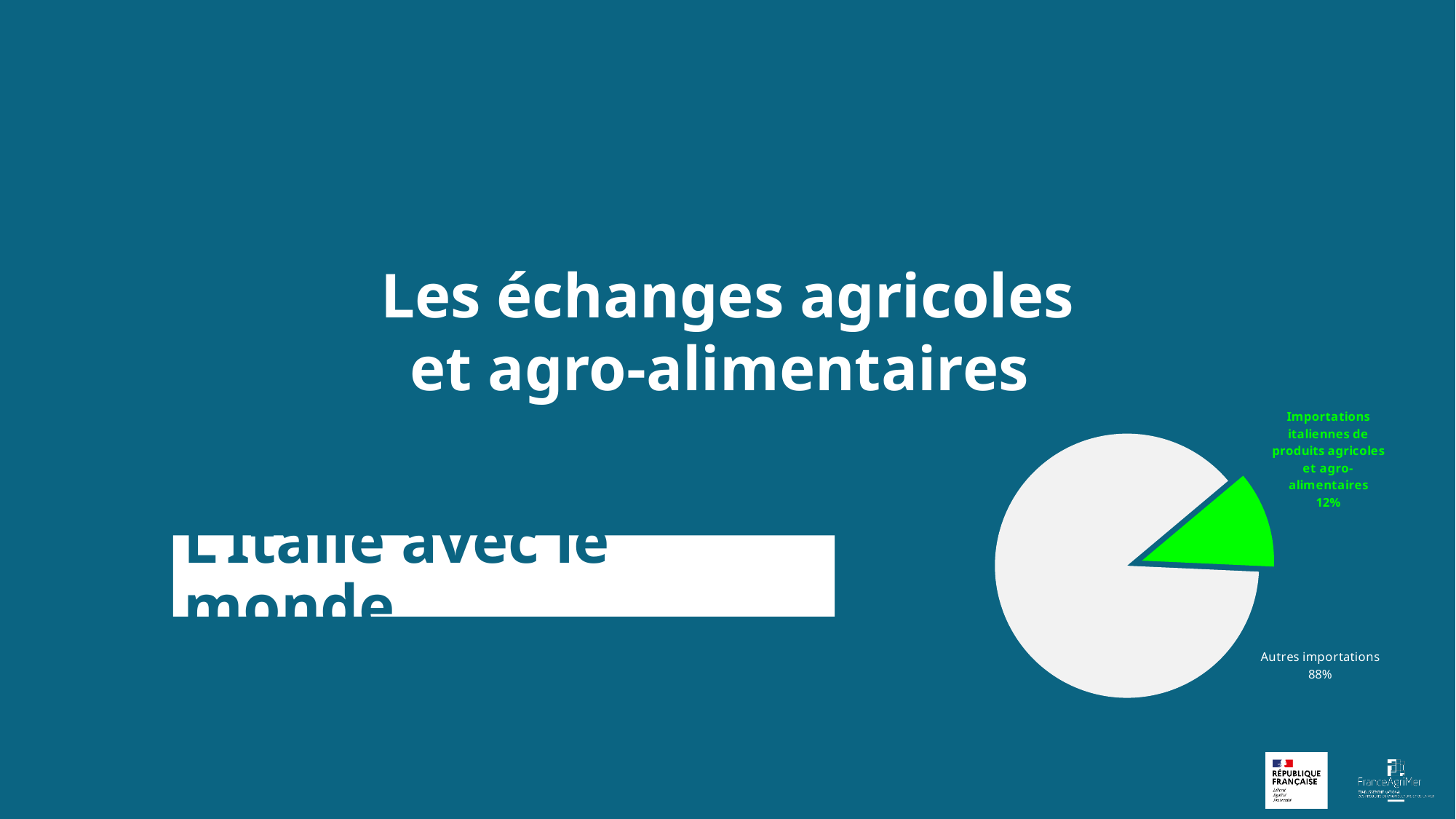
What colour is the "Autres importations" slice? light grey Which slice of the pie chart is the largest? Autres importations What share of the pie is labelled "Autres importations"? 88% How many slices does the pie chart have? 2 What share of the pie is labelled "Importations italiennes de produits agricoles et agro-alimentaires"? 12% Which is larger: the "Autres importations" slice or the "Importations italiennes de produits agricoles et agro-alimentaires" slice? Autres importations What kind of chart is shown on the slide? pie chart What colour is the "Importations italiennes de produits agricoles et agro-alimentaires" slice? green Which slice of the pie chart is the smallest? Importations italiennes de produits agricoles et agro-alimentaires What is the difference in percentage points between the "Autres importations" slice and the "Importations italiennes de produits agricoles et agro-alimentaires" slice? 76 What is the total of the two percentages shown on the pie chart? 100%